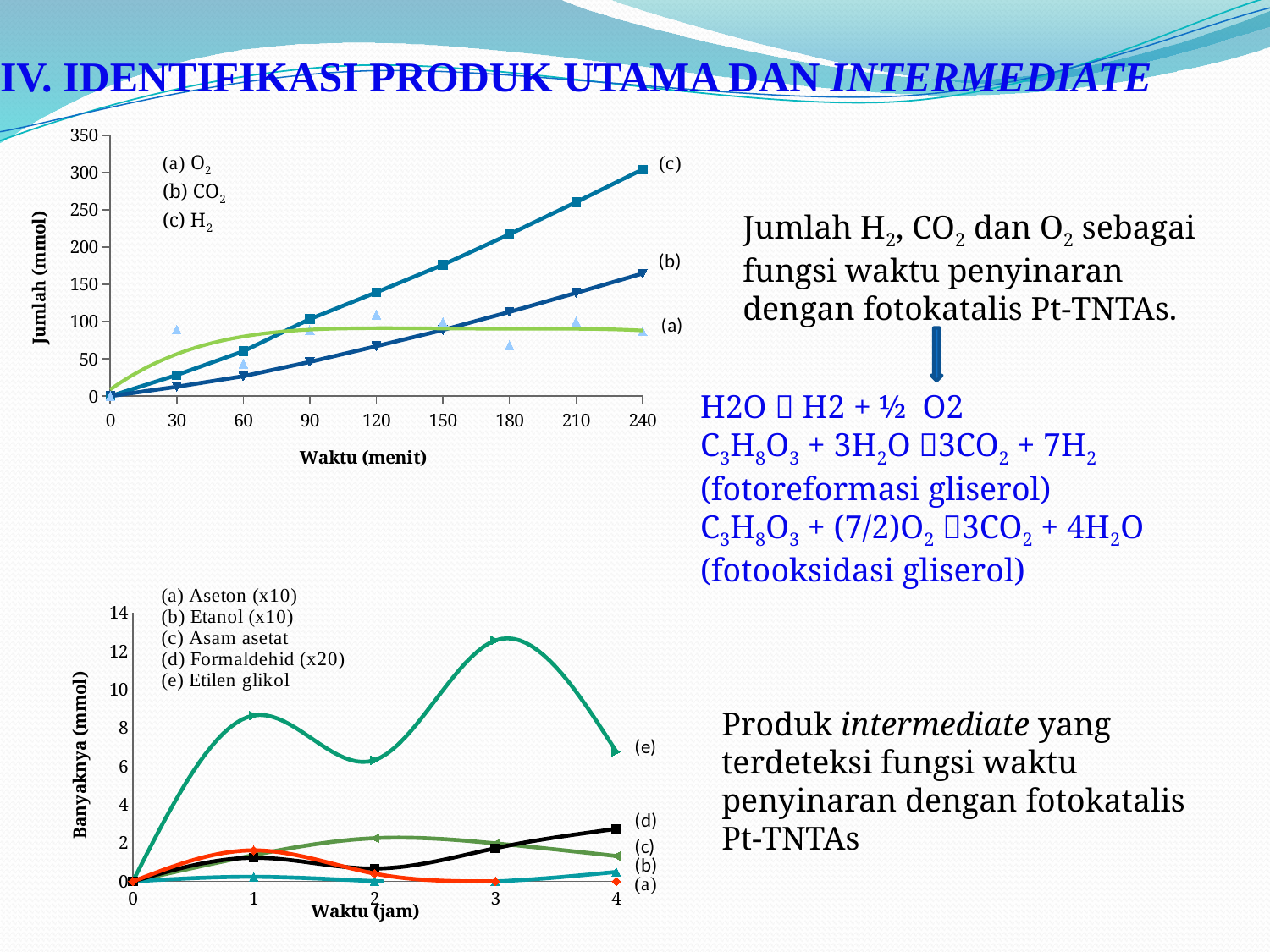
In the top chart, does the value for (c) H2 rise or fall as time increases from 0 to 240 minutes? rise In the top chart, which series has the highest value at 240 minutes? (c) H2 In the top chart, which series has the lowest value at 240 minutes? (a) O2 In the top chart, is the value for (a) O2 at 240 minutes greater or less than 100? less In the bottom chart, is the value for (e) Etilen glikol at 3 hours greater or less than 12? greater In the bottom chart, how many series does the legend list? 5 In the top chart, is the value for (c) H2 at 240 minutes greater or less than 250? greater In the bottom chart, which series has the highest value at 3 hours? (e) Etilen glikol What kind of chart is the bottom chart? line chart In the top chart, how many series does the legend list? 3 In the top chart, what is the x-axis title? Waktu (menit)